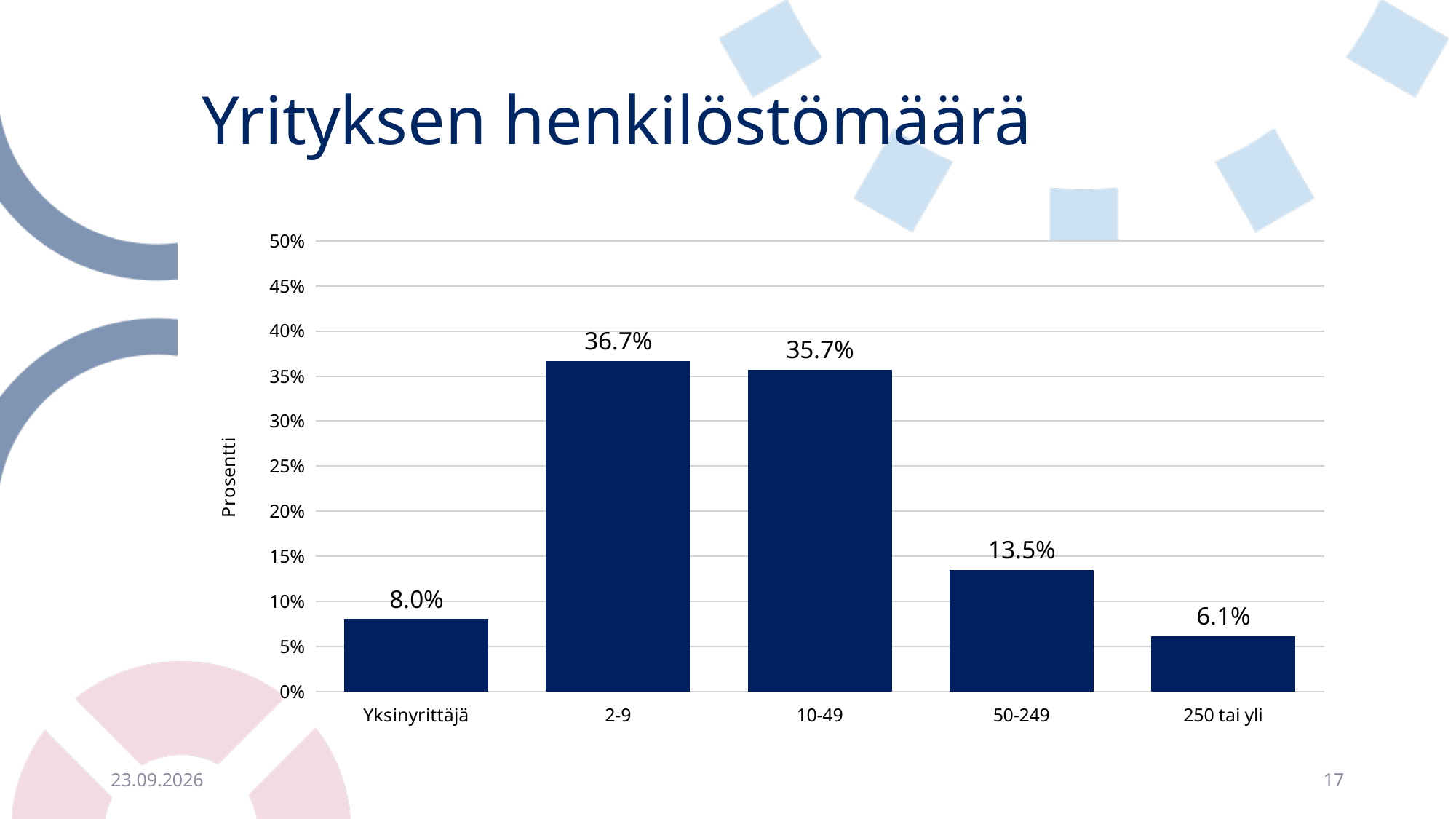
Which category has the lowest value? 250 tai yli What is the label of the vertical axis? Prosentti What is the value for the 2-9 category? 36.7% What is the value for the 50-249 category? 13.5% What is the difference between the values for 2-9 and 10-49? 1.0% What is the value for Yksinyrittäjä? 8.0% What is the value for the 250 tai yli category? 6.1% Which category has the highest value? 2-9 What kind of chart is shown on the slide? Bar chart How many categories are shown on the x axis? 5 Which is larger, the value for Yksinyrittäjä or the value for 50-249? 50-249 What is the value for the 10-49 category? 35.7%